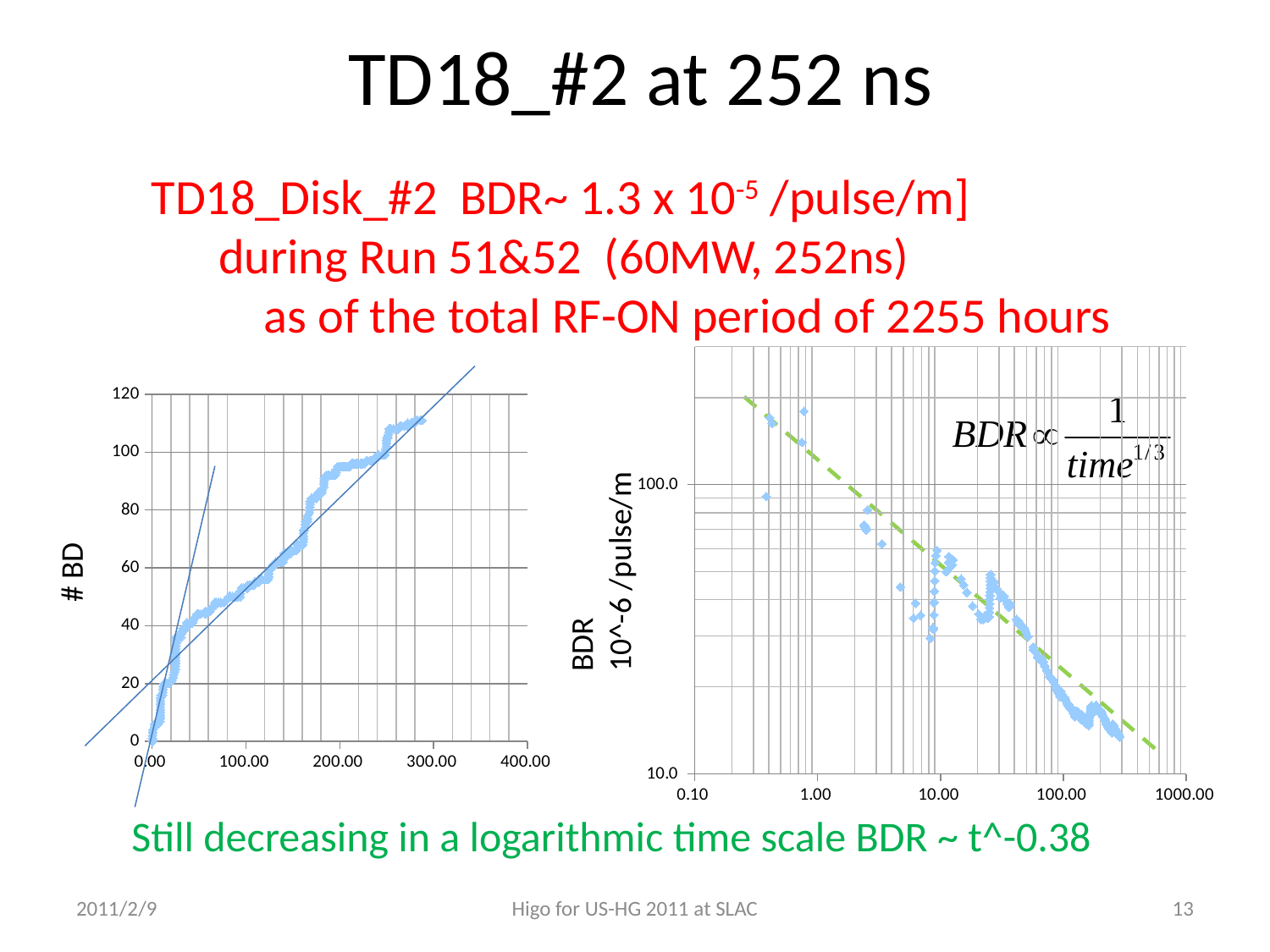
In the right chart, do the BDR values rise or fall as time increases along the x axis? fall What kind of chart is the right chart with the BDR axis? scatter chart In the left chart, is the highest # BD value reached greater or less than 100? greater What kind of chart is the left chart with the # BD axis? scatter chart How many charts are shown on the slide? 2 In the left chart, is the # BD value at x = 100.00 greater or less than 60? less In the right chart, is the BDR value at time 100.00 greater or less than 100.0? less What is the label of the y axis on the left chart? # BD What is the highest tick value shown on the y axis of the left chart? 120 In the left chart, do the # BD values rise or fall as the x axis increases? rise